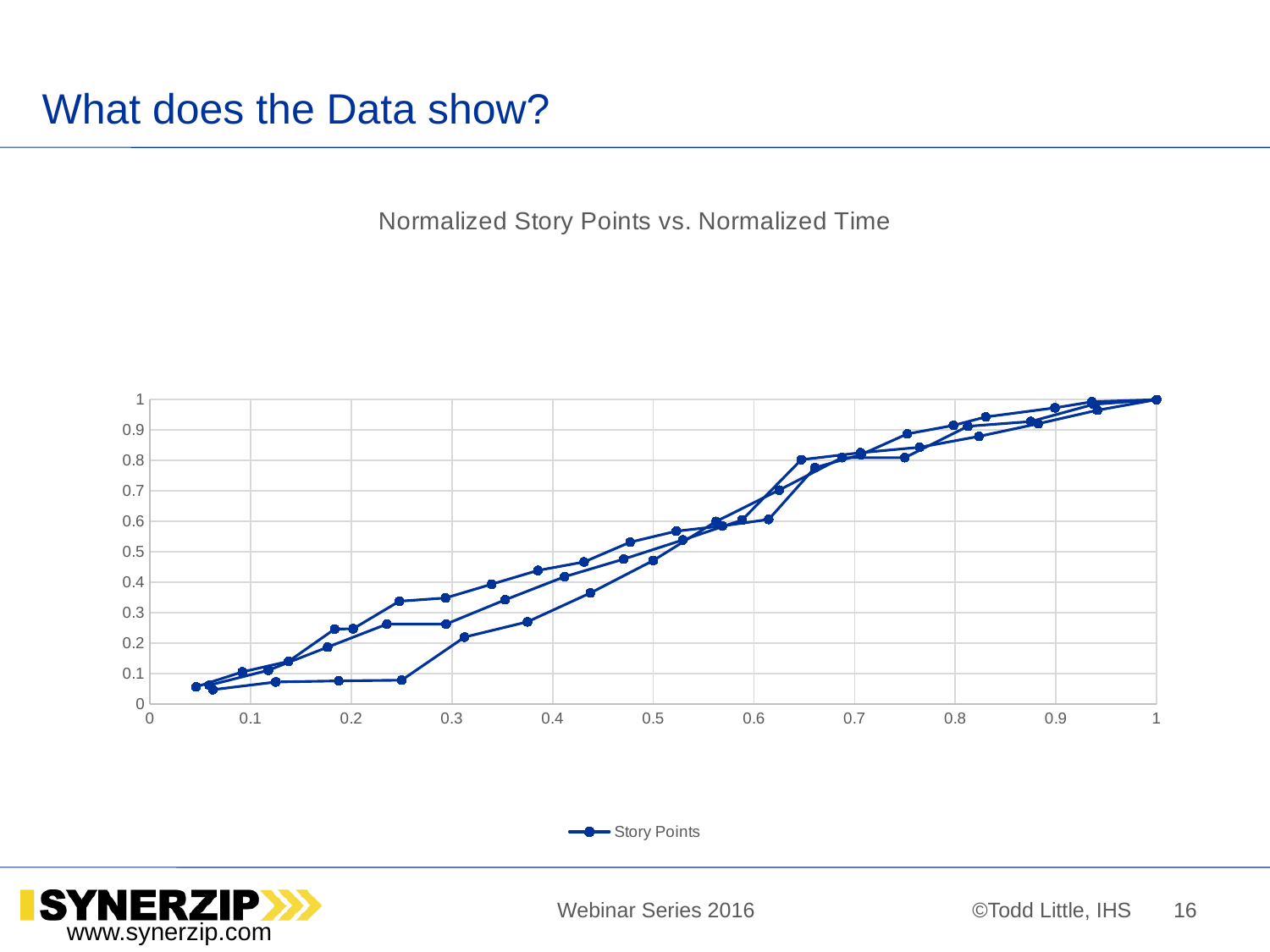
Is the value of the lowest line at normalized time 0.2 greater or less than 0.2? less What is the normalized story points value where the lines end at normalized time 1? 1 What is the title of the chart? Normalized Story Points vs. Normalized Time Is the value of the highest line at normalized time 0.8 greater or less than 0.8? greater What kind of chart is shown on the slide? line chart Is the value of the highest line at normalized time 0.3 greater or less than 0.4? less What is the maximum value shown on the y axis? 1 What is the name of the series shown in the legend? Story Points How many series does the legend list? 1 Do the plotted values rise or fall as normalized time increases along the x axis? rise